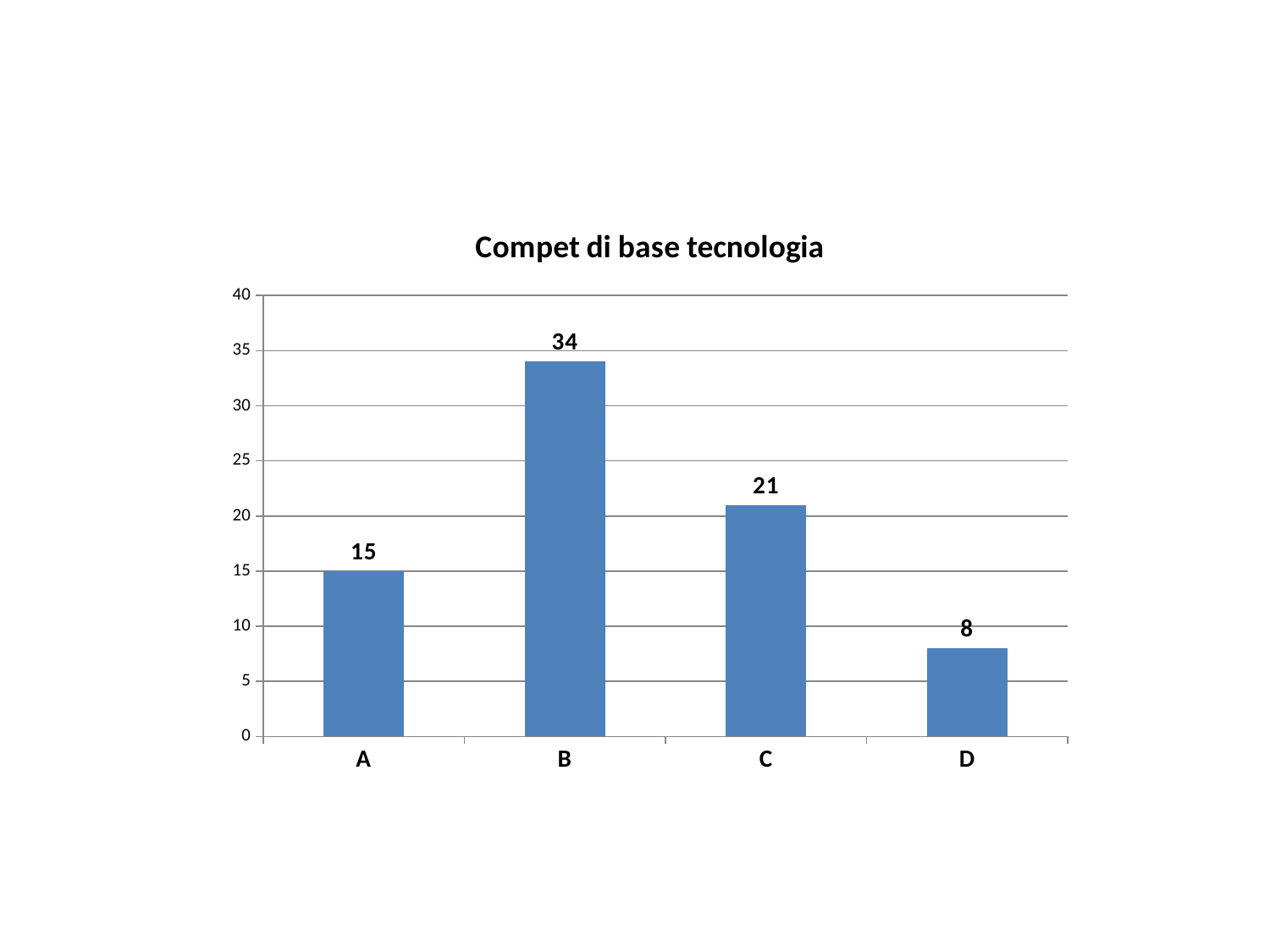
What is the difference between the values for A and D? 7 What is the value for category B? 34 How many categories are shown on the x axis? 4 Which category has the lowest value? D Which category has the highest value? B Which is larger, the value for A or the value for C? C What is the title of the chart? Compet di base tecnologia What is the difference between the values for B and C? 13 Is the value for C greater or less than 20? greater What is the value for category D? 8 What is the value for category A? 15 What kind of chart is shown on the slide? bar chart